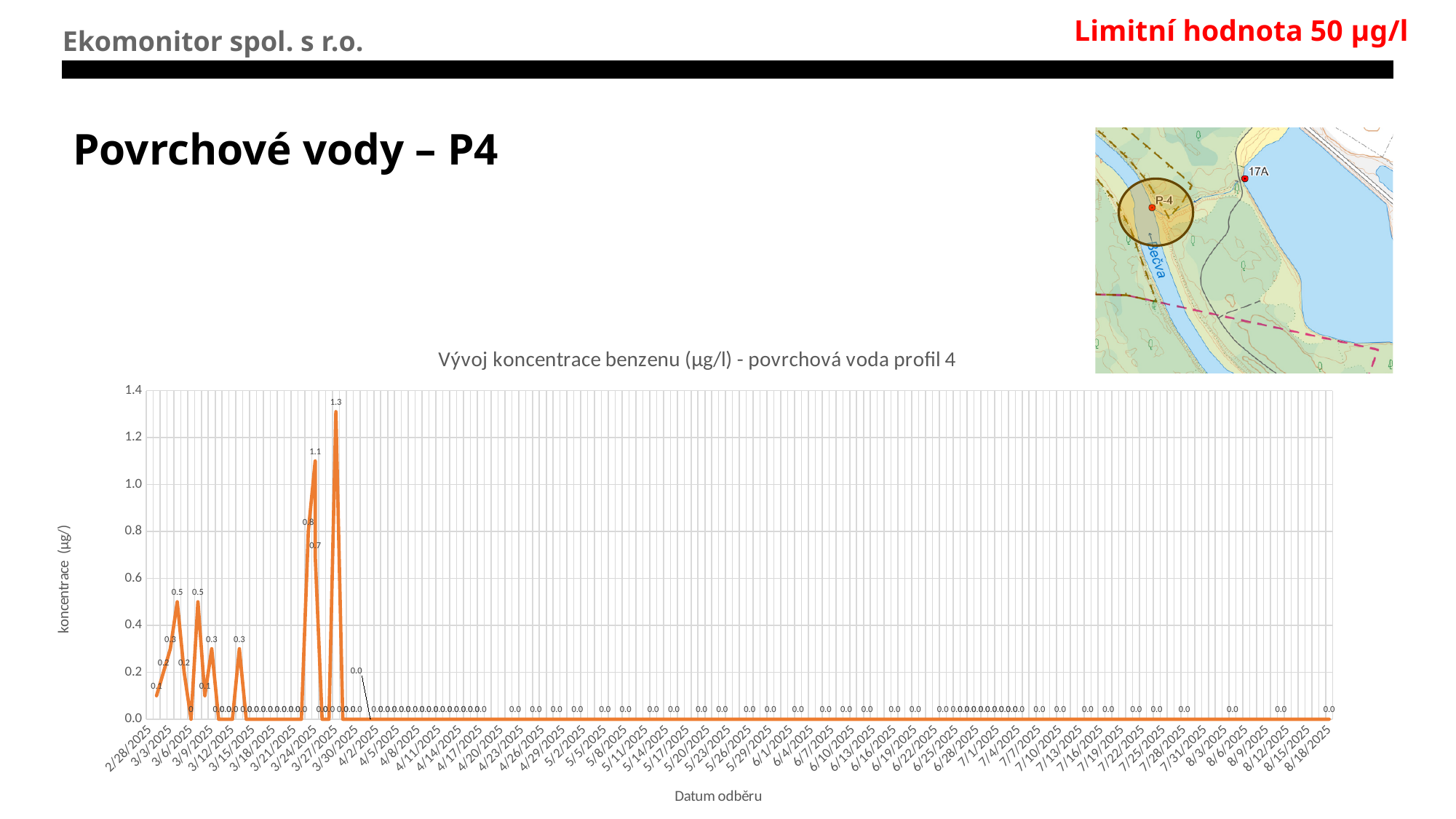
What is the highest benzene concentration value labelled on the chart? 1.3 What is the concentration value at the last date, 8/18/2025? 0.0 What is the difference between the two highest labelled peaks, 1.3 and 1.1? 0.2 What is the title of the chart? Vývoj koncentrace benzenu (µg/l) - povrchová voda profil 4 Which is larger, the peak labelled 1.3 or the peak labelled 1.1? 1.3 Is the highest value on the chart greater or less than 1.2? greater What is the label of the y axis? koncentrace (µg/l) What kind of chart is shown on the slide? line chart What is the concentration value at the first date, 2/28/2025? 0.1 What is the lowest value labelled on the chart? 0.0 Is the value at 8/18/2025 greater or less than 0.2? less